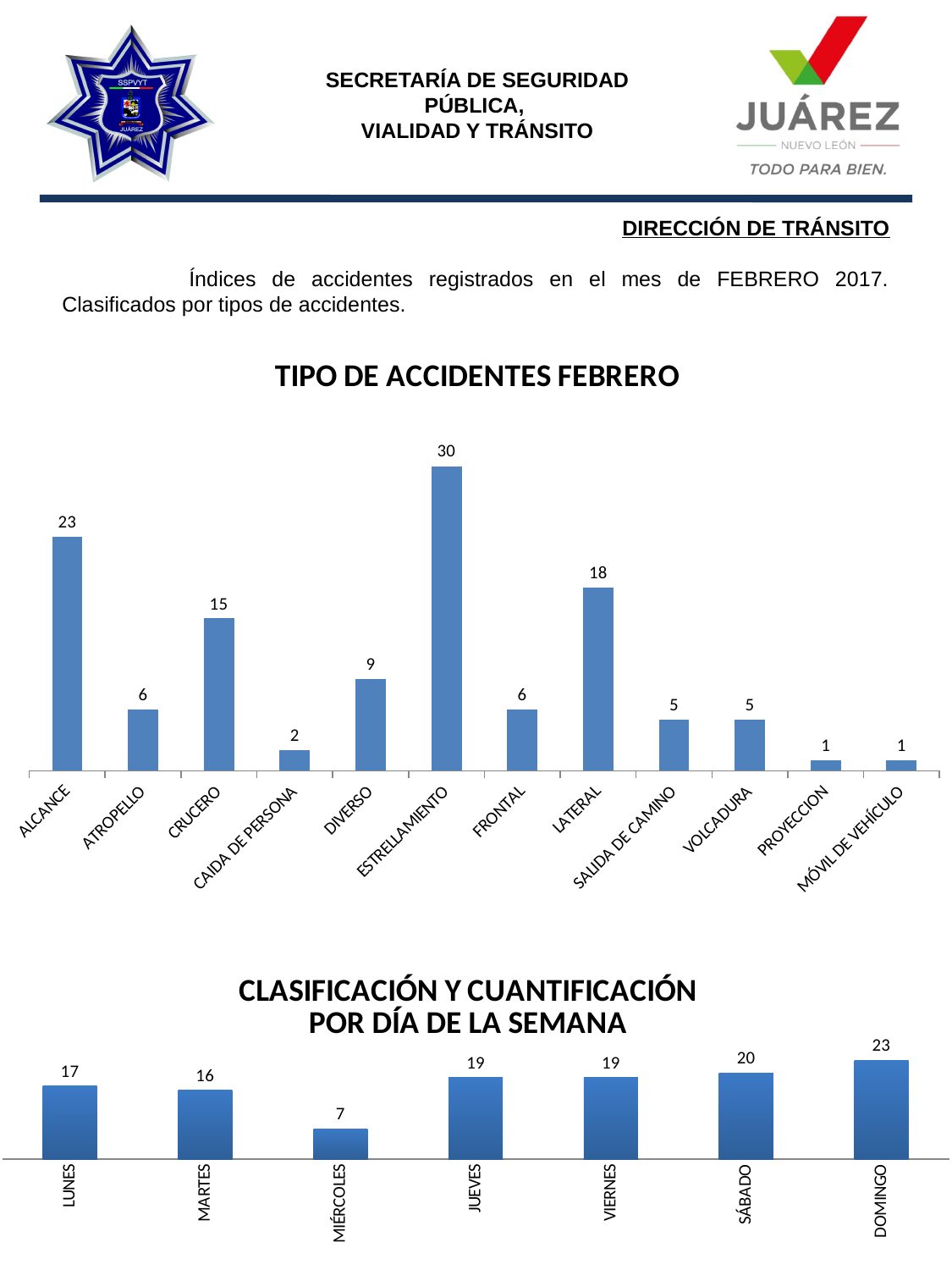
What kind of chart is 'TIPO DE ACCIDENTES FEBRERO'? Bar chart In the 'CLASIFICACIÓN Y CUANTIFICACIÓN POR DÍA DE LA SEMANA' chart, what is the value for MIÉRCOLES? 7 How many categories are shown in the 'TIPO DE ACCIDENTES FEBRERO' chart? 12 In the 'TIPO DE ACCIDENTES FEBRERO' chart, what is the difference between ALCANCE and LATERAL? 5 In the 'CLASIFICACIÓN Y CUANTIFICACIÓN POR DÍA DE LA SEMANA' chart, what is the difference between DOMINGO and SÁBADO? 3 In the 'TIPO DE ACCIDENTES FEBRERO' chart, which is larger, DIVERSO or FRONTAL? DIVERSO In the 'CLASIFICACIÓN Y CUANTIFICACIÓN POR DÍA DE LA SEMANA' chart, which day has the lowest value? MIÉRCOLES How many days are shown in the 'CLASIFICACIÓN Y CUANTIFICACIÓN POR DÍA DE LA SEMANA' chart? 7 In the 'CLASIFICACIÓN Y CUANTIFICACIÓN POR DÍA DE LA SEMANA' chart, which day has the highest value? DOMINGO In the 'TIPO DE ACCIDENTES FEBRERO' chart, what is the value for CRUCERO? 15 In the 'TIPO DE ACCIDENTES FEBRERO' chart, what is the value for ESTRELLAMIENTO? 30 In the 'TIPO DE ACCIDENTES FEBRERO' chart, which category has the highest value? ESTRELLAMIENTO